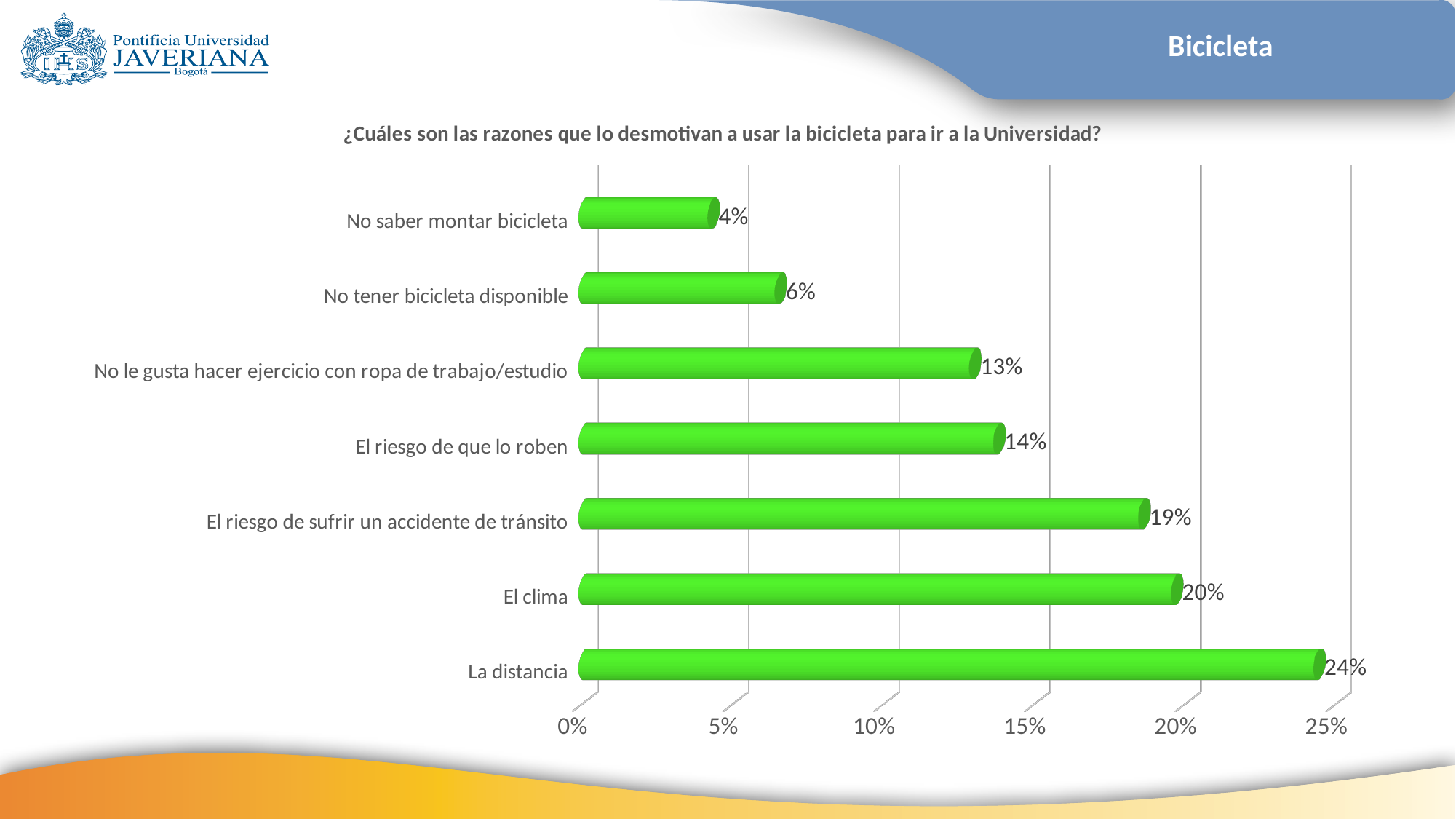
How many categories are shown in the chart? 7 Which is larger, the value for "El riesgo de que lo roben" or the value for "No le gusta hacer ejercicio con ropa de trabajo/estudio"? El riesgo de que lo roben What is the difference between the values for "El riesgo de sufrir un accidente de tránsito" and "No saber montar bicicleta"? 15% What is the difference between the values for "La distancia" and "El clima"? 4% What kind of chart is shown on the slide? Bar chart What is the value for "La distancia"? 24% What is the value for "No tener bicicleta disponible"? 6% What is the value for "El riesgo de que lo roben"? 14% Which category has the highest value? La distancia Which category has the lowest value? No saber montar bicicleta What is the value for "El clima"? 20% What is the title of the chart? ¿Cuáles son las razones que lo desmotivan a usar la bicicleta para ir a la Universidad?